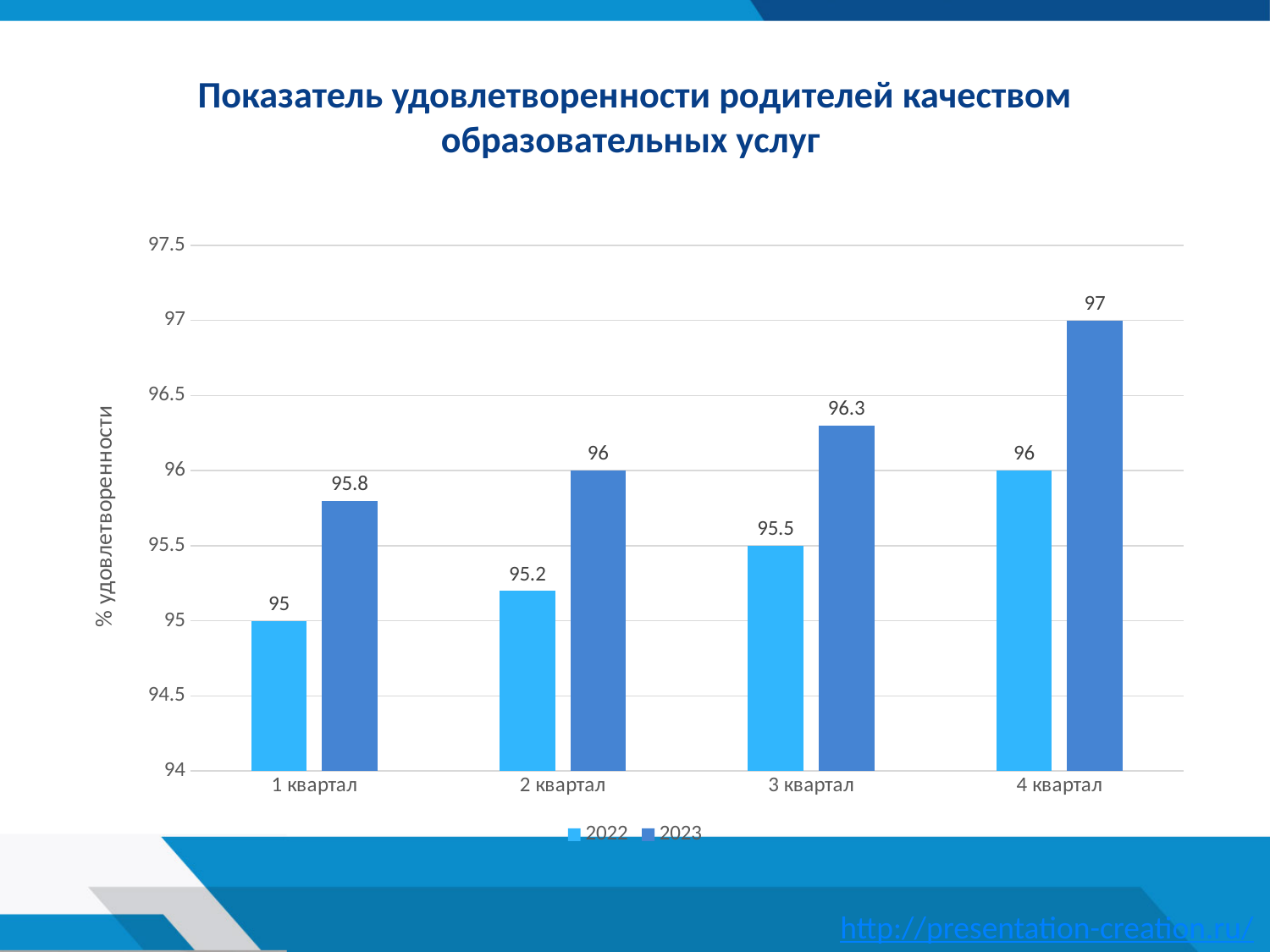
What is the difference between the 2023 and 2022 values in 4 квартал? 1 What kind of chart is shown on the slide? bar chart What is the value for 2022 in 2 квартал? 95.2 Do the 2022 values rise or fall from 1 квартал to 4 квартал? rise Which is larger in 3 квартал: the 2022 value or the 2023 value? 2023 Which quarter has the lowest value for the 2022 series? 1 квартал What is the value for 2022 in 4 квартал? 96 What is the value for 2023 in 3 квартал? 96.3 Which quarter has the highest value for the 2023 series? 4 квартал What is the difference between the 2023 and 2022 values in 1 квартал? 0.8 How many series does the legend list? 2 How many quarters are shown on the x axis? 4